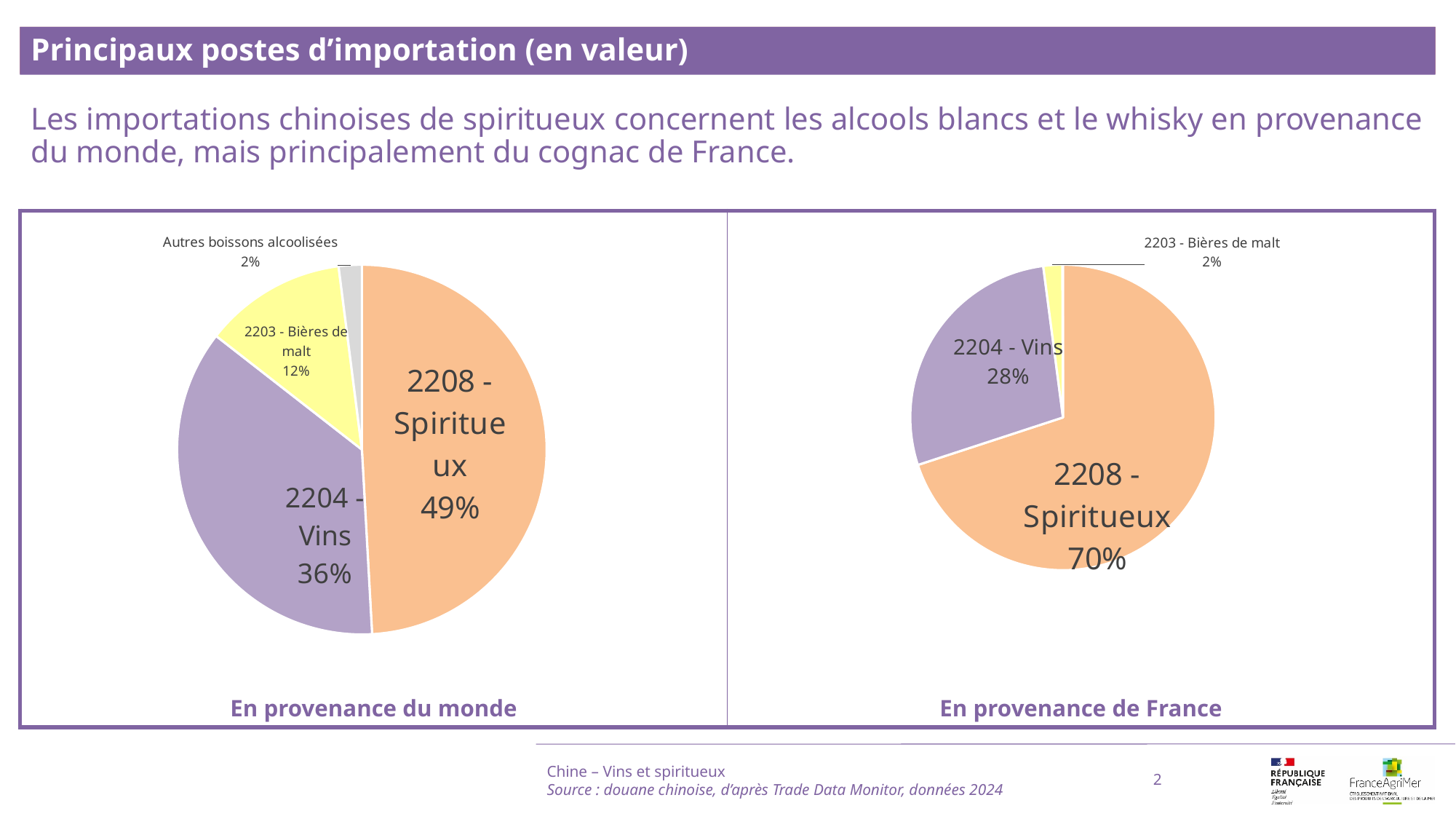
In the 'En provenance de France' chart, what share do 2203 - Bières de malt represent? 2% In the 'En provenance de France' chart, what share do 2204 - Vins represent? 28% What type of chart is used on this slide? Pie chart In the 'En provenance de France' chart, what share do 2208 - Spiritueux represent? 70% How many slices does the 'En provenance du monde' chart have? 4 What is the difference in percentage points between the 2208 - Spiritueux share in the 'En provenance de France' chart and in the 'En provenance du monde' chart? 21 percentage points In the 'En provenance du monde' chart, what share do 2203 - Bières de malt represent? 12% In the 'En provenance de France' chart, which category has the smallest slice? 2203 - Bières de malt In the 'En provenance du monde' chart, which category has the largest slice? 2208 - Spiritueux In the 'En provenance du monde' chart, what share do 2204 - Vins represent? 36% In the 'En provenance du monde' chart, what share do 2208 - Spiritueux represent? 49% In the 'En provenance du monde' chart, what share do Autres boissons alcoolisées represent? 2%